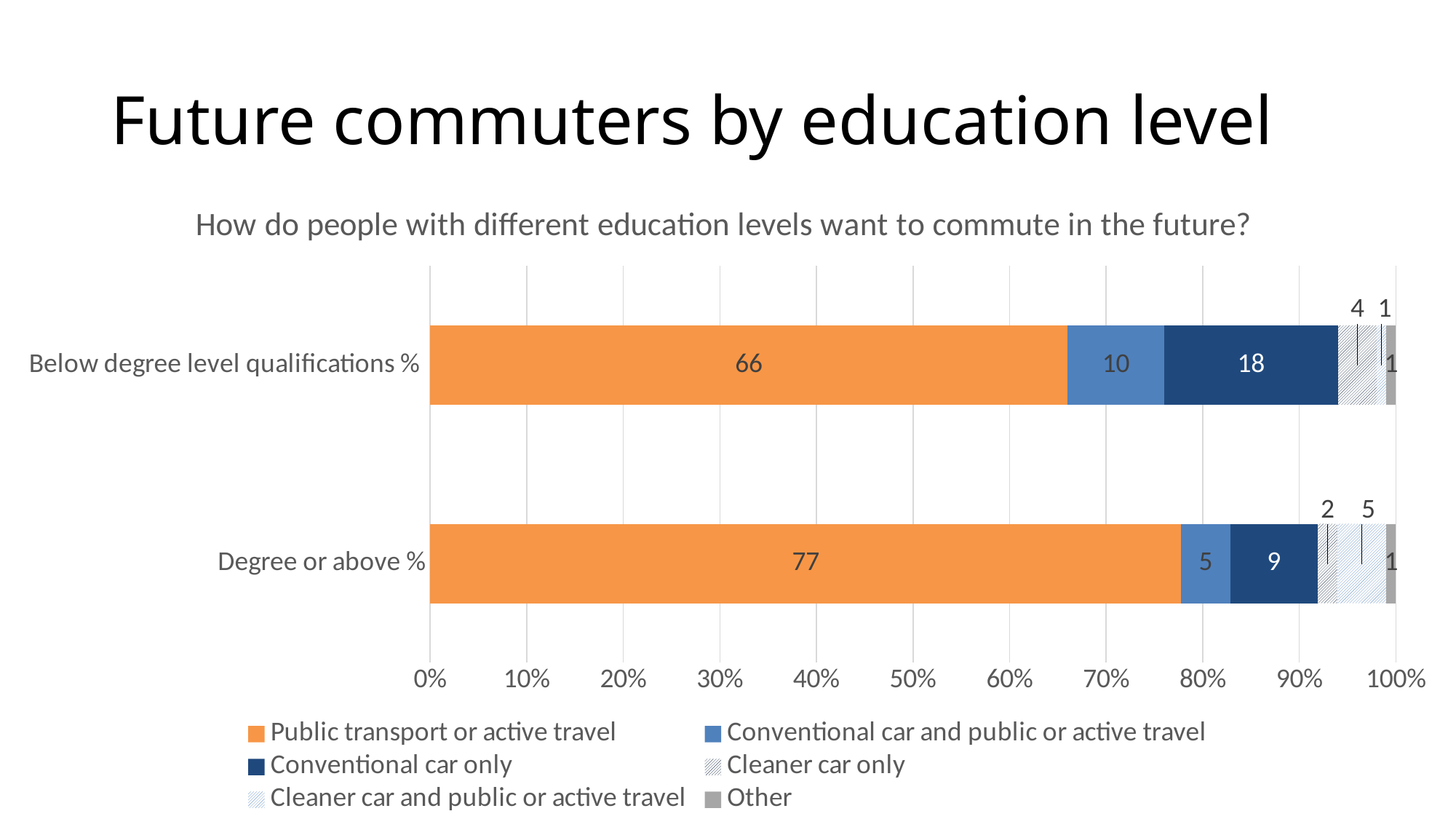
What is the difference between the Conventional car only values for Below degree level qualifications % and Degree or above %? 9 How many series does the legend list? 6 How many education level categories are shown in the chart? 2 What is the value for Public transport or active travel for Degree or above %? 77 What is the value for Conventional car only for Below degree level qualifications %? 18 Which is larger: Conventional car and public or active travel for Below degree level qualifications % or for Degree or above %? Below degree level qualifications % What kind of chart is shown on the slide? Stacked bar chart What is the value for Cleaner car only for Below degree level qualifications %? 4 Which education level has the higher value for Public transport or active travel? Degree or above % What is the value for Conventional car and public or active travel for Degree or above %? 5 What is the total of the stacked bar for Below degree level qualifications %? 100 What is the value for Cleaner car and public or active travel for Degree or above %? 5